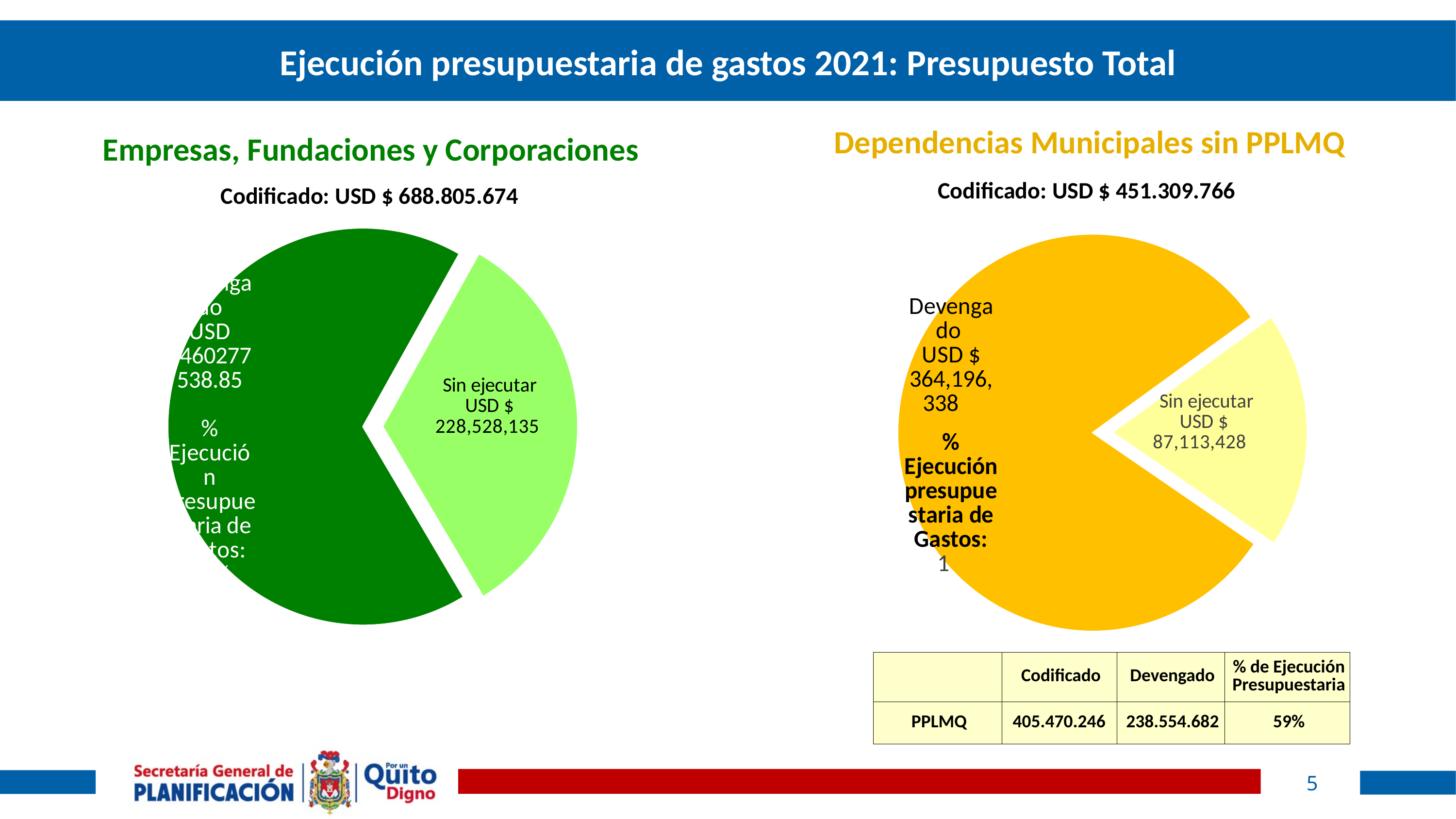
In the 'Dependencias Municipales sin PPLMQ' chart, what is the value of the 'Sin ejecutar' slice? USD $ 87,113,428 In the 'Empresas, Fundaciones y Corporaciones' chart, which slice is the largest? Devengado In the 'Dependencias Municipales sin PPLMQ' chart, what is the difference between the 'Devengado' and 'Sin ejecutar' values? USD $ 277,082,910 Which chart has the larger 'Sin ejecutar' value, 'Empresas, Fundaciones y Corporaciones' or 'Dependencias Municipales sin PPLMQ'? Empresas, Fundaciones y Corporaciones How many slices does the 'Empresas, Fundaciones y Corporaciones' pie chart have? 2 In the 'Dependencias Municipales sin PPLMQ' chart, what is the value of the 'Devengado' slice? USD $ 364,196,338 In the 'Dependencias Municipales sin PPLMQ' chart, what is the total of the 'Devengado' and 'Sin ejecutar' slices? USD $ 451,309,766 In the 'Empresas, Fundaciones y Corporaciones' chart, what is the value of the 'Sin ejecutar' slice? USD $ 228,528,135 What 'Codificado' amount is shown above the 'Empresas, Fundaciones y Corporaciones' chart? USD $ 688.805.674 What kind of chart is shown under the heading 'Empresas, Fundaciones y Corporaciones'? Pie chart In the 'Dependencias Municipales sin PPLMQ' chart, which slice is larger, 'Devengado' or 'Sin ejecutar'? Devengado How many slices does the 'Dependencias Municipales sin PPLMQ' pie chart have? 2